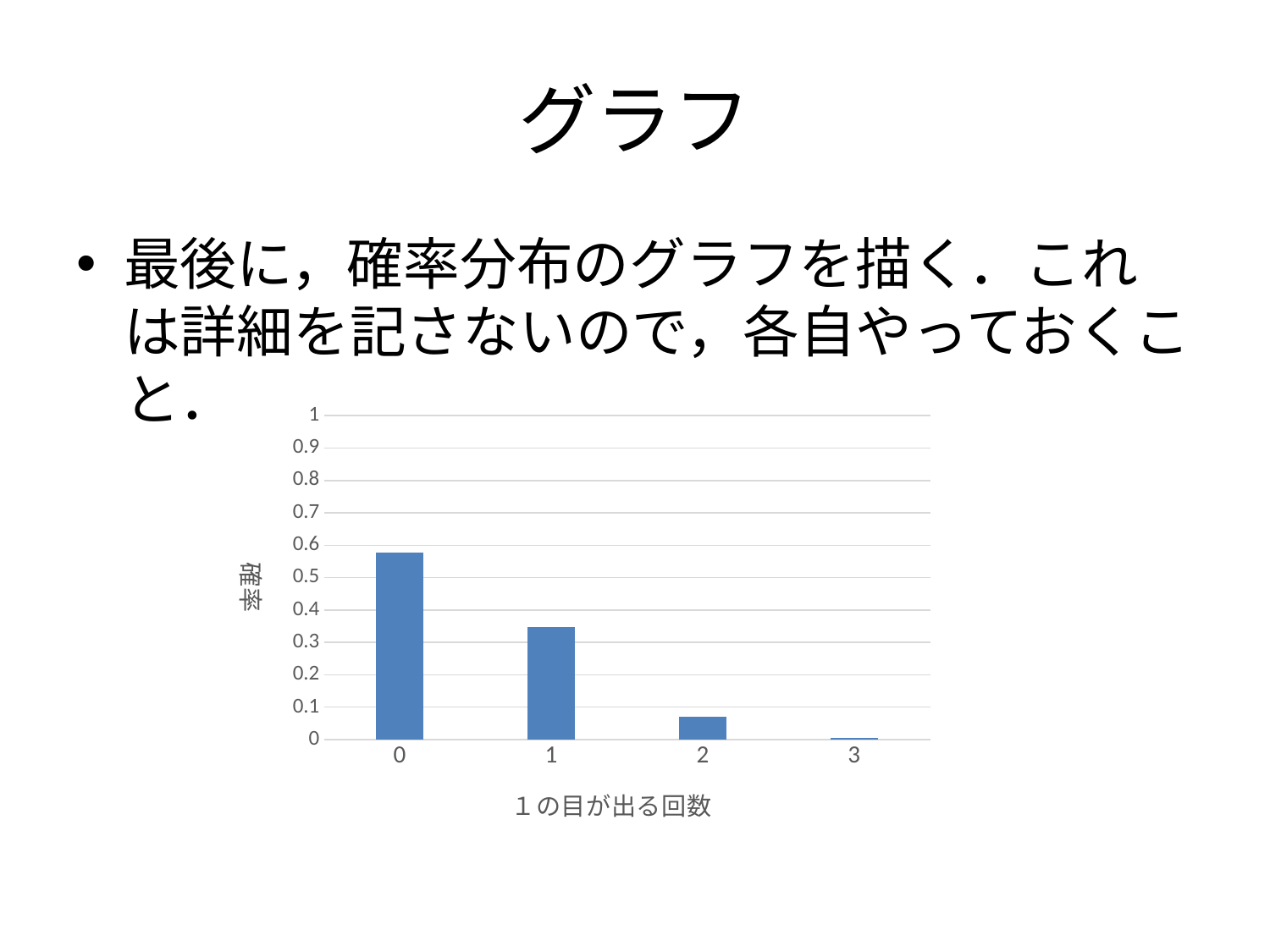
Which category on the x axis has the highest bar? 0 What is the title of the y axis of the chart? 確率 Do the values rise or fall as you move from category 0 to category 3 along the x axis? fall What kind of chart is shown on the slide? bar chart Is the value for category 1 greater or less than 0.4? less Which category on the x axis has the lowest bar? 3 Is the value for category 0 greater or less than 0.5? greater Is the value for category 2 greater or less than 0.1? less Which is larger, the value for category 1 or the value for category 2? category 1 How many categories are plotted along the x axis of the chart? 4 What is the title of the x axis of the chart? １の目が出る回数